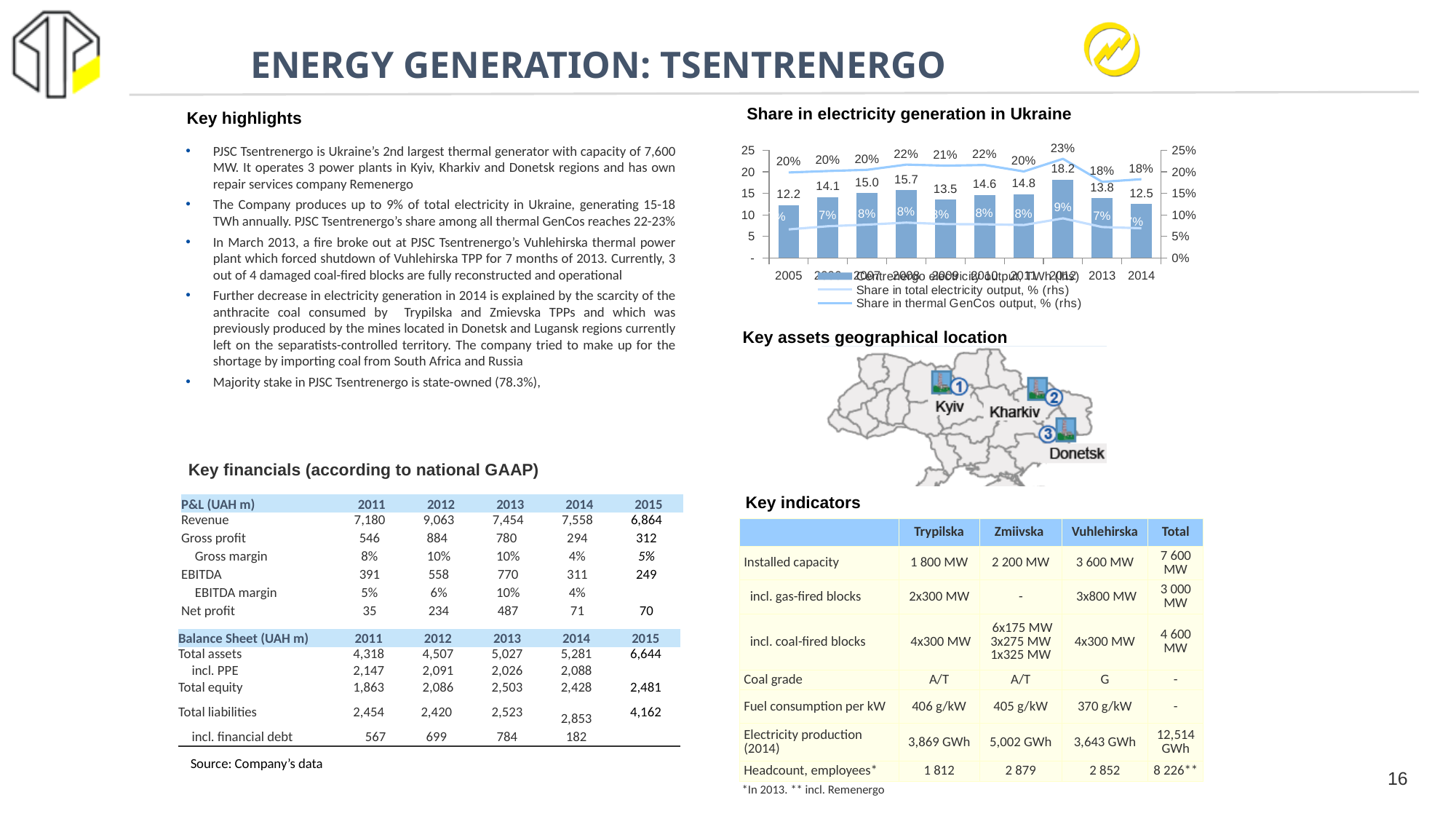
In the 'Share in electricity generation in Ukraine' chart, what is Tsentrenergo's electricity output (TWh) in 2012? 18.2 How many series does the legend of the 'Share in electricity generation in Ukraine' chart list? 3 In the 'Share in electricity generation in Ukraine' chart, what is Tsentrenergo's electricity output (TWh) in 2005? 12.2 What kind of chart is the 'Share in electricity generation in Ukraine' chart? bar chart with line series In the 'Share in electricity generation in Ukraine' chart, does Tsentrenergo's electricity output rise or fall from 2012 to 2014? fall In the 'Share in electricity generation in Ukraine' chart, which year has the highest Tsentrenergo electricity output (TWh)? 2012 In the 'Share in electricity generation in Ukraine' chart, what is the difference between Tsentrenergo's electricity output in 2012 and 2013 (TWh)? 4.4 In the 'Share in electricity generation in Ukraine' chart, which year has the larger Tsentrenergo electricity output, 2008 or 2009? 2008 In the 'Share in electricity generation in Ukraine' chart, what is the share in thermal GenCos output in 2012? 23% In the 'Share in electricity generation in Ukraine' chart, is Tsentrenergo's electricity output in 2014 greater or less than 15? less In the 'Share in electricity generation in Ukraine' chart, which year has the lowest Tsentrenergo electricity output (TWh)? 2005 How many years are shown on the x axis of the 'Share in electricity generation in Ukraine' chart? 10